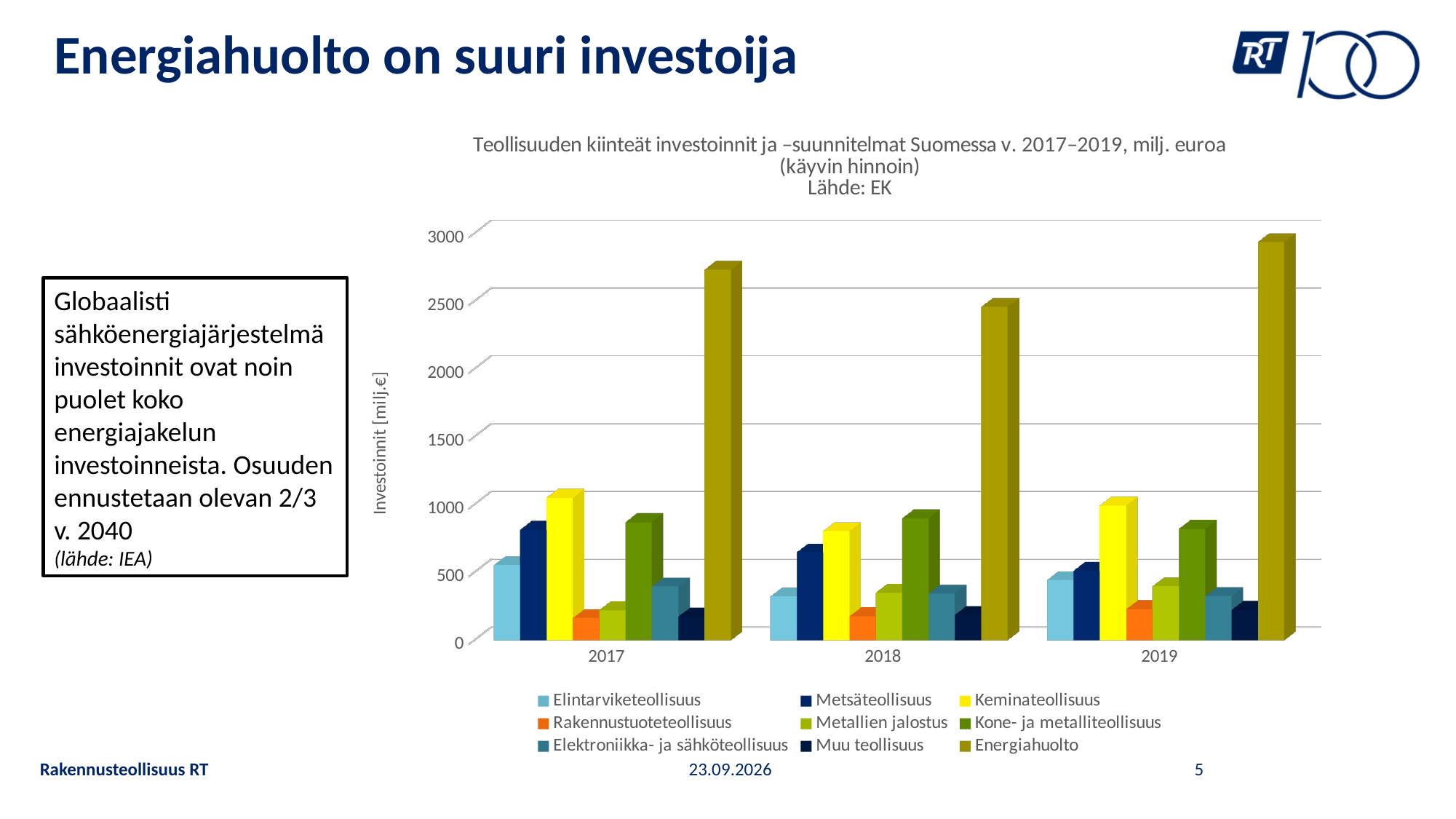
Is the value for Energiahuolto in 2017 greater or less than 2500? greater Is the value for Rakennustuoteteollisuus in 2017 greater or less than 500? less Which series has the highest value in 2017? Energiahuolto What kind of chart is shown on the slide? bar chart Which series has the highest value in 2019? Energiahuolto How many years (categories) are shown on the x axis of the chart? 3 Is the value for Keminateollisuus in 2018 greater or less than 1000? less What is the label of the chart's vertical axis? Investoinnit [milj.€] Which is larger: the value for Energiahuolto in 2017 or in 2018? 2017 How many series does the chart legend list? 9 Which is larger: the value for Energiahuolto in 2019 or in 2017? 2019